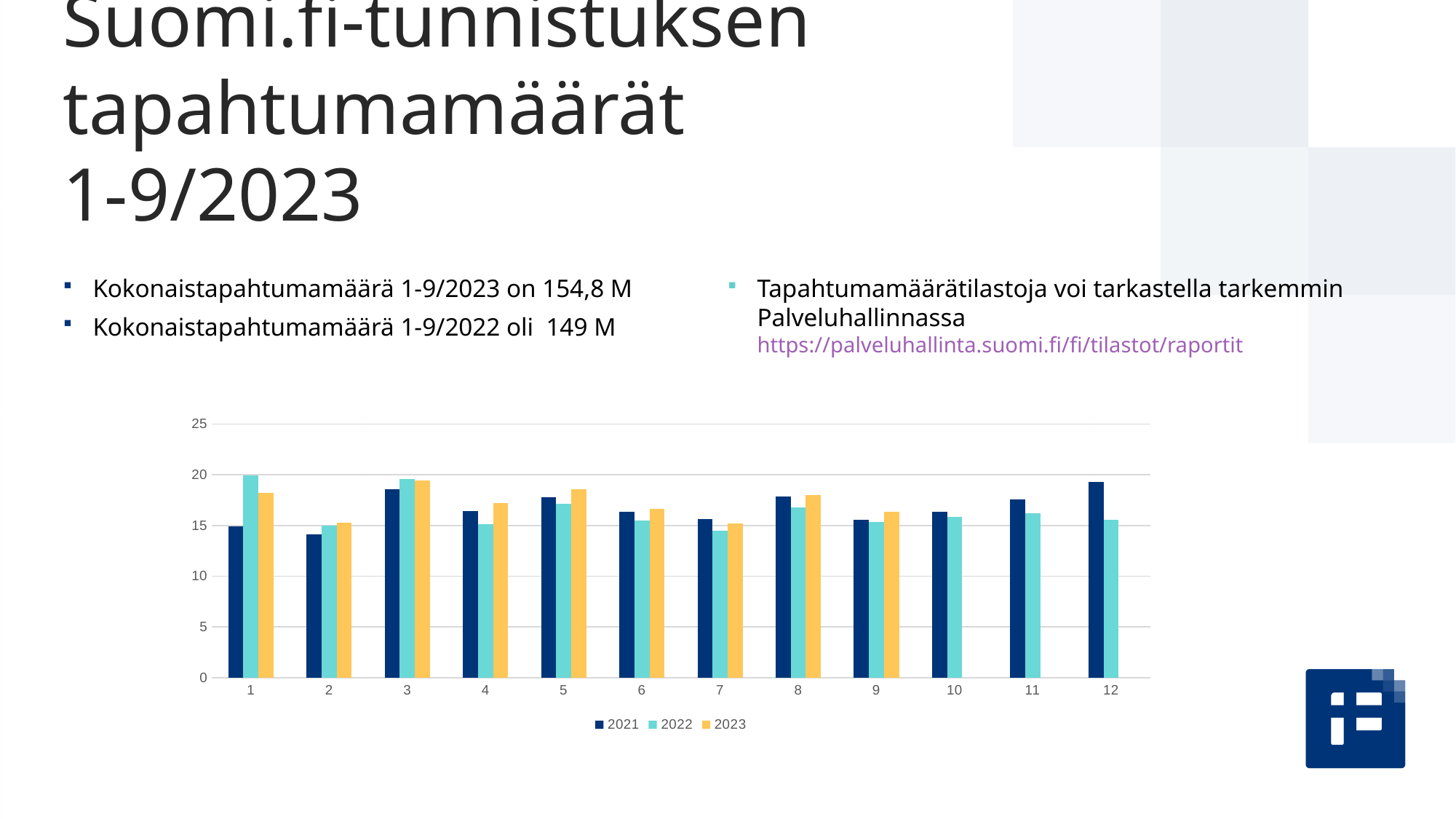
Is the value for 2023 in category 5 greater or less than 15? greater Is the value for 2022 in category 1 greater or less than 25? less In category 1, which series has the larger value, 2021 or 2022? 2022 Which series are listed in the chart legend? 2021, 2022, 2023 Which category has the highest value for the 2021 series? 12 What kind of chart is shown on the slide? bar chart For how many categories does the 2023 series have a bar? 9 Is the value for 2022 in category 7 greater or less than 15? less In category 12, which series has the larger value, 2021 or 2022? 2021 How many series does the chart legend list? 3 How many categories are shown on the x axis of the chart? 12